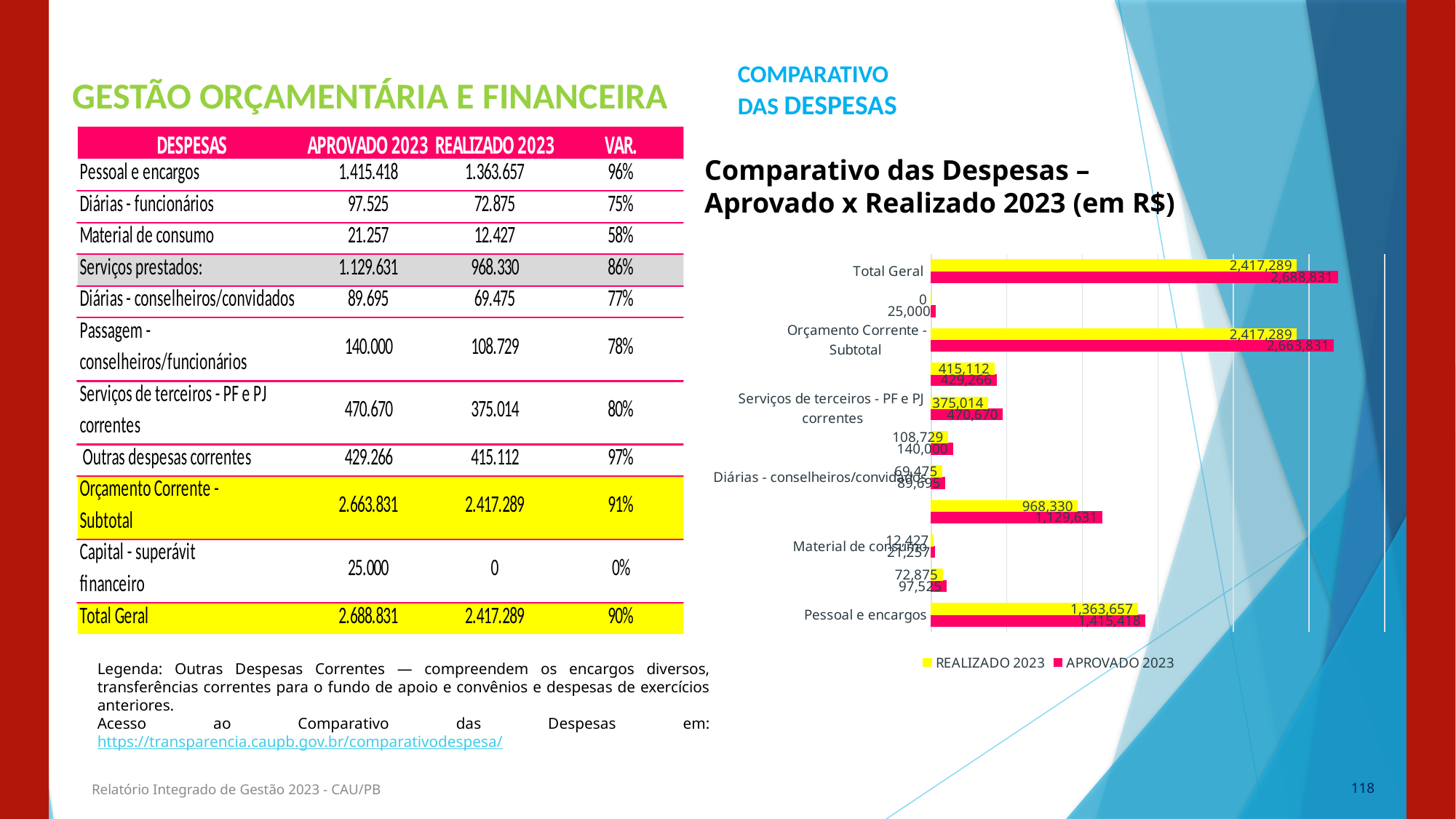
How many series does the chart legend list? 2 In the chart, what is the APROVADO 2023 value for Total Geral? 2,688,831 In the chart, which labelled category has the lowest APROVADO 2023 value? Material de consumo Which series is shown in yellow in the chart? REALIZADO 2023 In the chart, what is the difference between the APROVADO 2023 and REALIZADO 2023 values for Pessoal e encargos? 51,761 In the chart, what is the difference between the APROVADO 2023 values for Total Geral and Orçamento Corrente - Subtotal? 25,000 In the chart, what is the REALIZADO 2023 value for Total Geral? 2,417,289 In the chart, what is the APROVADO 2023 value for Material de consumo? 21,257 In the chart, what is the APROVADO 2023 value for Pessoal e encargos? 1,415,418 In the chart, which is larger for Diárias - conselheiros/convidados: the APROVADO 2023 value or the REALIZADO 2023 value? APROVADO 2023 What kind of chart is shown on the slide? bar chart In the chart, what is the REALIZADO 2023 value for Serviços de terceiros - PF e PJ correntes? 375,014